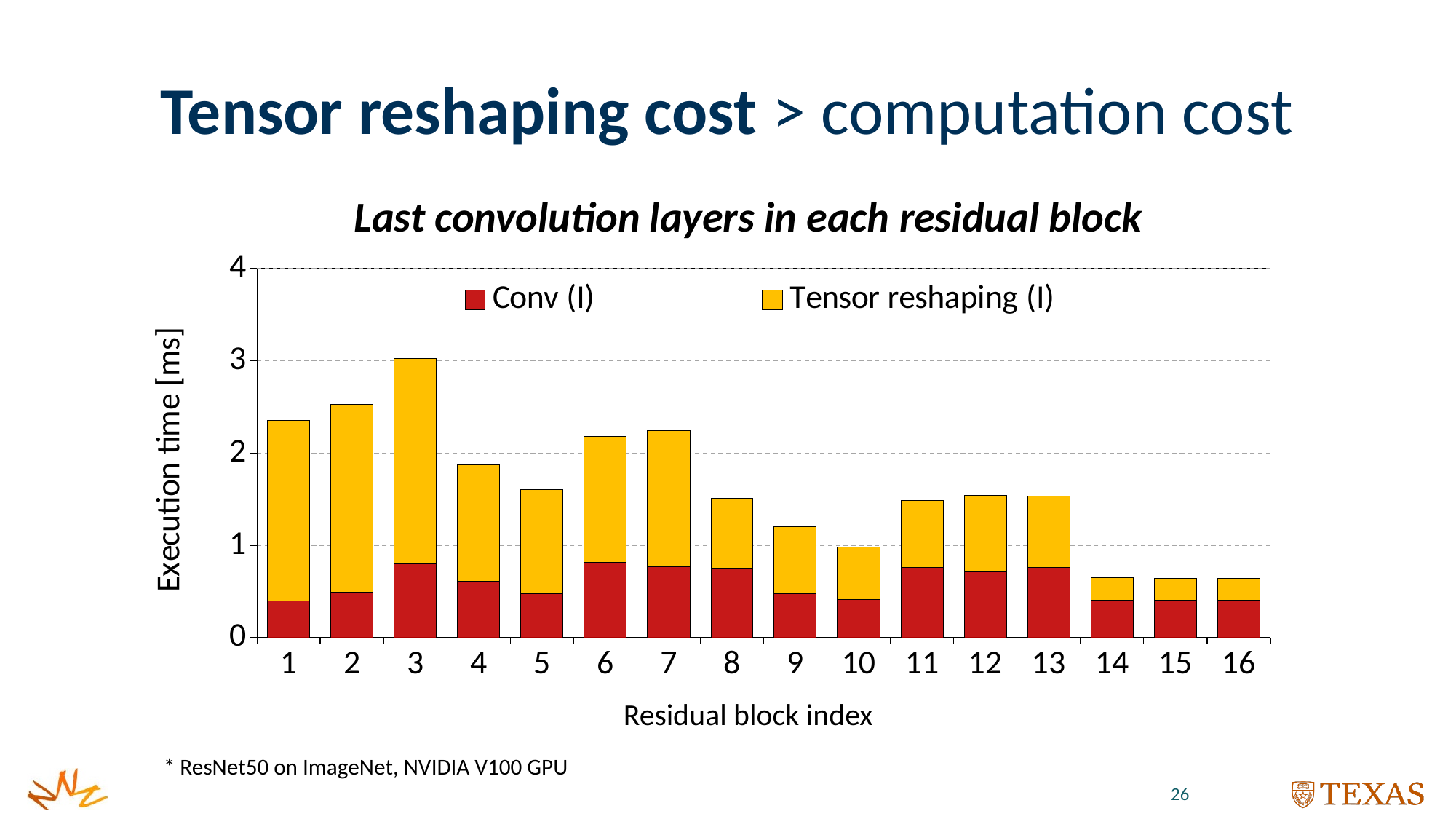
Which has the larger Conv (I) execution time, residual block 3 or residual block 1? Residual block 3 Which residual block index has the highest total execution time? 3 What kind of chart is shown on the slide? Stacked bar chart Is the total execution time for residual block 3 greater or less than 2 ms? greater Is the total execution time for residual block 14 greater or less than 1 ms? less From residual block 3 to residual block 5, do the total execution times rise or fall? Fall What is the label of the y axis? Execution time [ms] How many residual block indices are shown on the x axis? 16 Is the total execution time for residual block 9 greater or less than 1 ms? greater Which has the larger total execution time, residual block 1 or residual block 16? Residual block 1 How many series does the legend list? 2